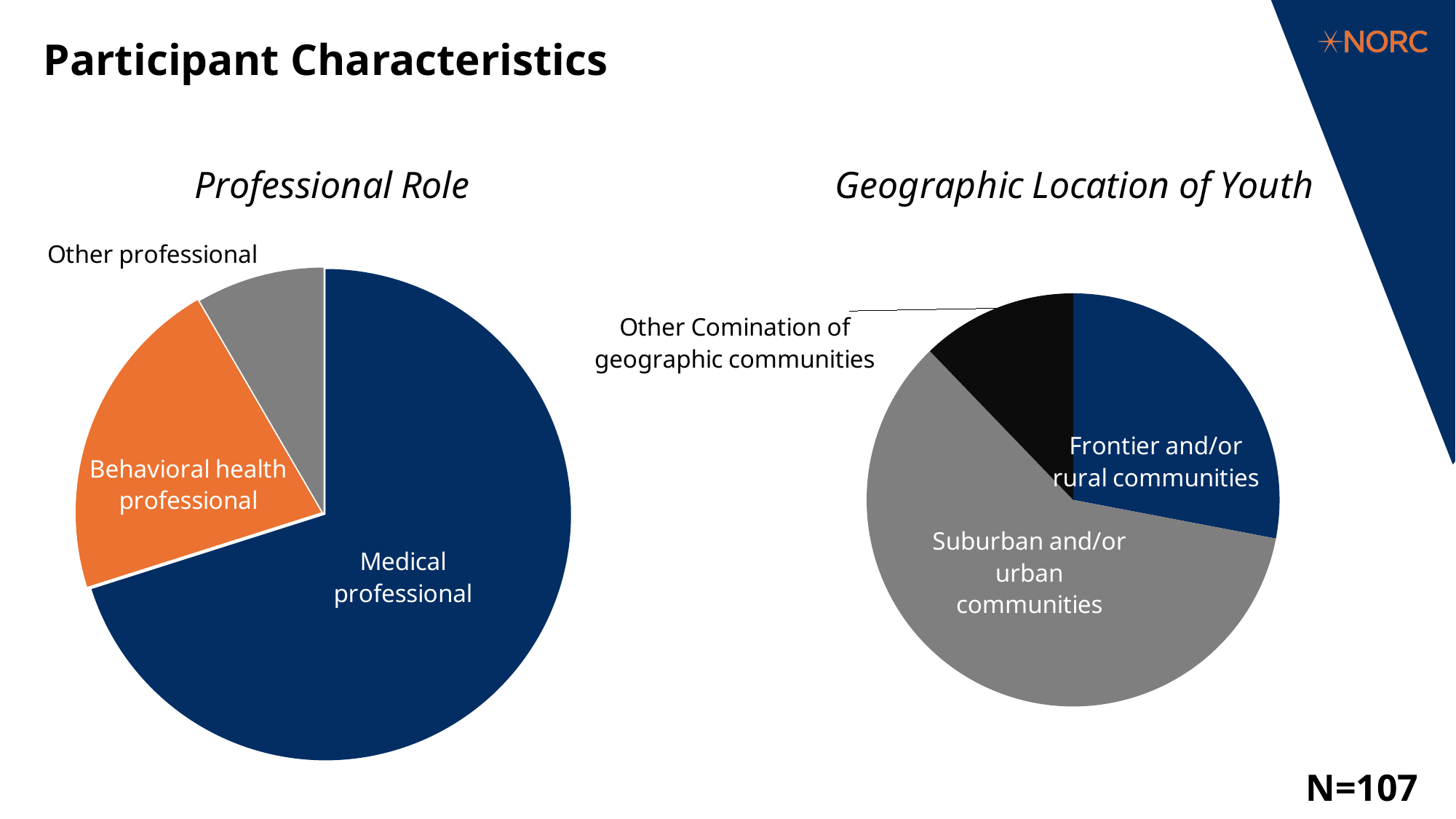
In the Geographic Location of Youth chart, which slice is larger: Frontier and/or rural communities or Other Comination of geographic communities? Frontier and/or rural communities In the Professional Role chart, what colour is the Behavioral health professional slice? Orange In the Professional Role chart, how many slices does the pie have? 3 In the Professional Role chart, which category has the smallest slice? Other professional What kind of chart is the Professional Role chart? Pie chart In the Professional Role chart, which slice is larger: Behavioral health professional or Other professional? Behavioral health professional In the Geographic Location of Youth chart, which category has the smallest slice? Other Comination of geographic communities In the Geographic Location of Youth chart, how many slices does the pie have? 3 In the Geographic Location of Youth chart, which category has the largest slice? Suburban and/or urban communities What is the title of the chart on the right side of the slide? Geographic Location of Youth In the Professional Role chart, which category has the largest slice? Medical professional What kind of chart is the Geographic Location of Youth chart? Pie chart